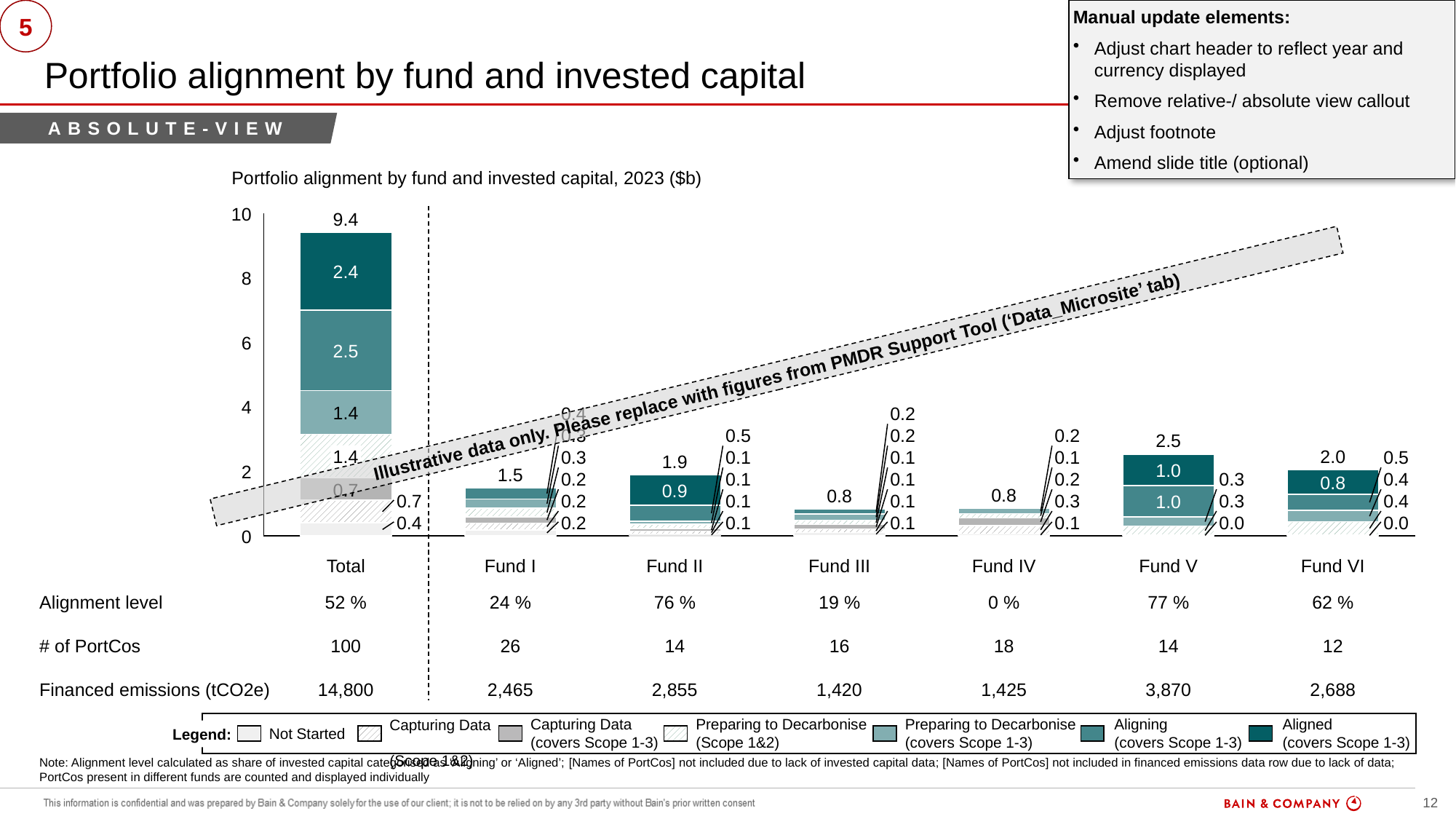
What is the value of the Aligned (covers Scope 1-3) segment in the Total bar? 2.4 Is the total for the Total bar greater or less than 8? greater Which has a larger total invested capital, Fund I or Fund II? Fund II What is the value of the Aligned (covers Scope 1-3) segment for Fund II? 0.9 What kind of chart is shown on the slide? Stacked bar chart What is the difference between the total for Fund V and the total for Fund VI? 0.5 What is the title of the chart? Portfolio alignment by fund and invested capital, 2023 ($b) Which fund (excluding Total) has the highest total invested capital? Fund V How many series does the legend list? 7 What is the alignment level shown for Fund V? 77 % What is the total invested capital shown for the Total bar? 9.4 How many categories are shown on the x axis of the chart? 7